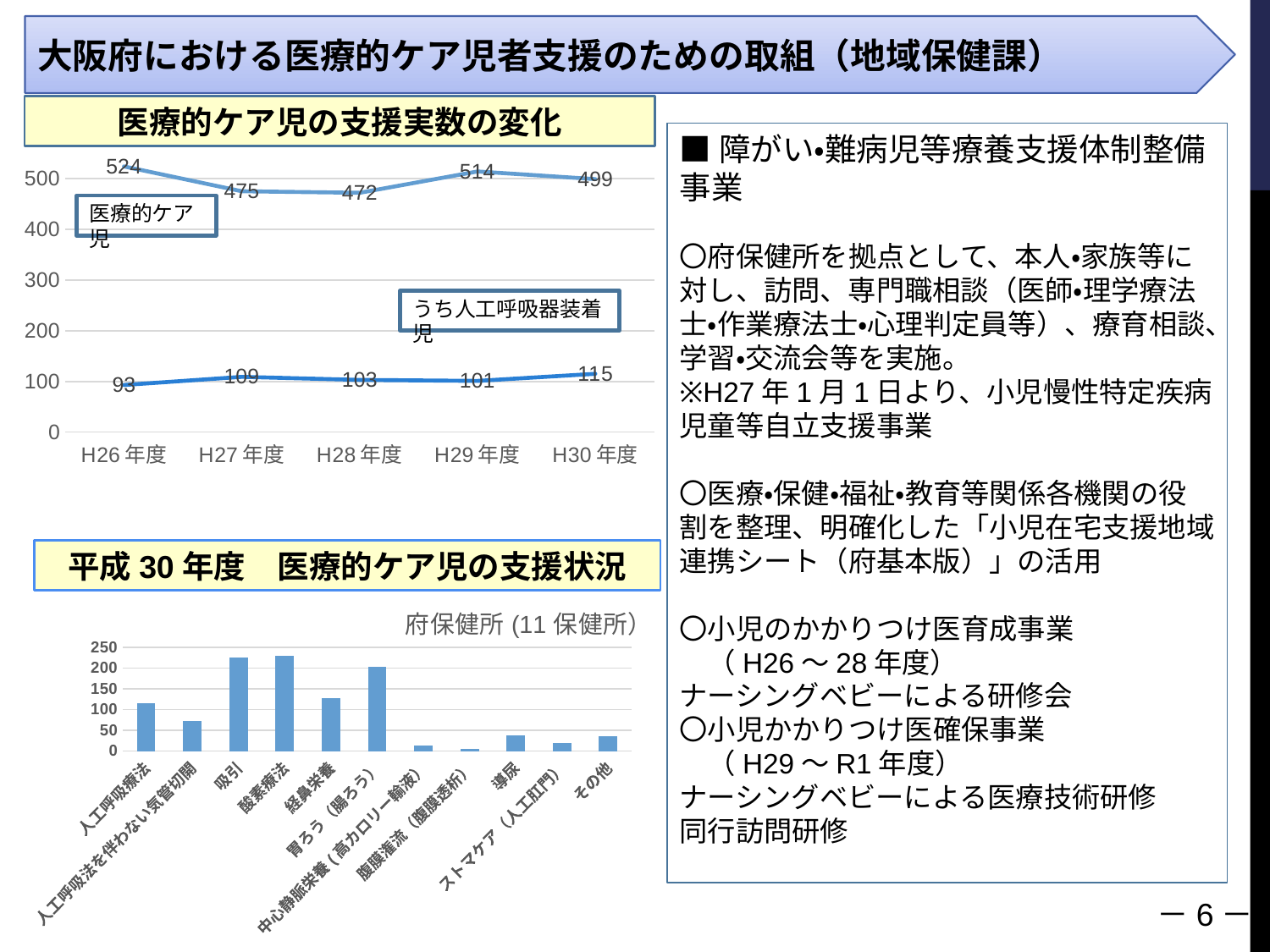
In the line chart 医療的ケア児の支援実数の変化, is the 医療的ケア児 value for H27年度 larger or smaller than the value for H29年度? smaller In the bar chart 平成30年度 医療的ケア児の支援状況, which category has the lowest value? 腹膜潅流（腹膜透析） In the line chart 医療的ケア児の支援実数の変化, which year has the highest value for うち人工呼吸器装着児? H30年度 In the line chart 医療的ケア児の支援実数の変化, what is the difference between the 医療的ケア児 values for H29年度 and H30年度? 15 What kind of chart is 平成30年度 医療的ケア児の支援状況? bar chart In the bar chart 平成30年度 医療的ケア児の支援状況, how many categories are shown on the x axis? 11 In the line chart 医療的ケア児の支援実数の変化, how many series are plotted? 2 In the bar chart 平成30年度 医療的ケア児の支援状況, is the value for 胃ろう（腸ろう） greater or less than 150? greater In the line chart 医療的ケア児の支援実数の変化, which year has the lowest value for 医療的ケア児? H28年度 In the line chart 医療的ケア児の支援実数の変化, what is the value for うち人工呼吸器装着児 in H30年度? 115 In the line chart 医療的ケア児の支援実数の変化, how many years are shown on the x axis? 5 In the line chart 医療的ケア児の支援実数の変化, what is the value for 医療的ケア児 in H26年度? 524